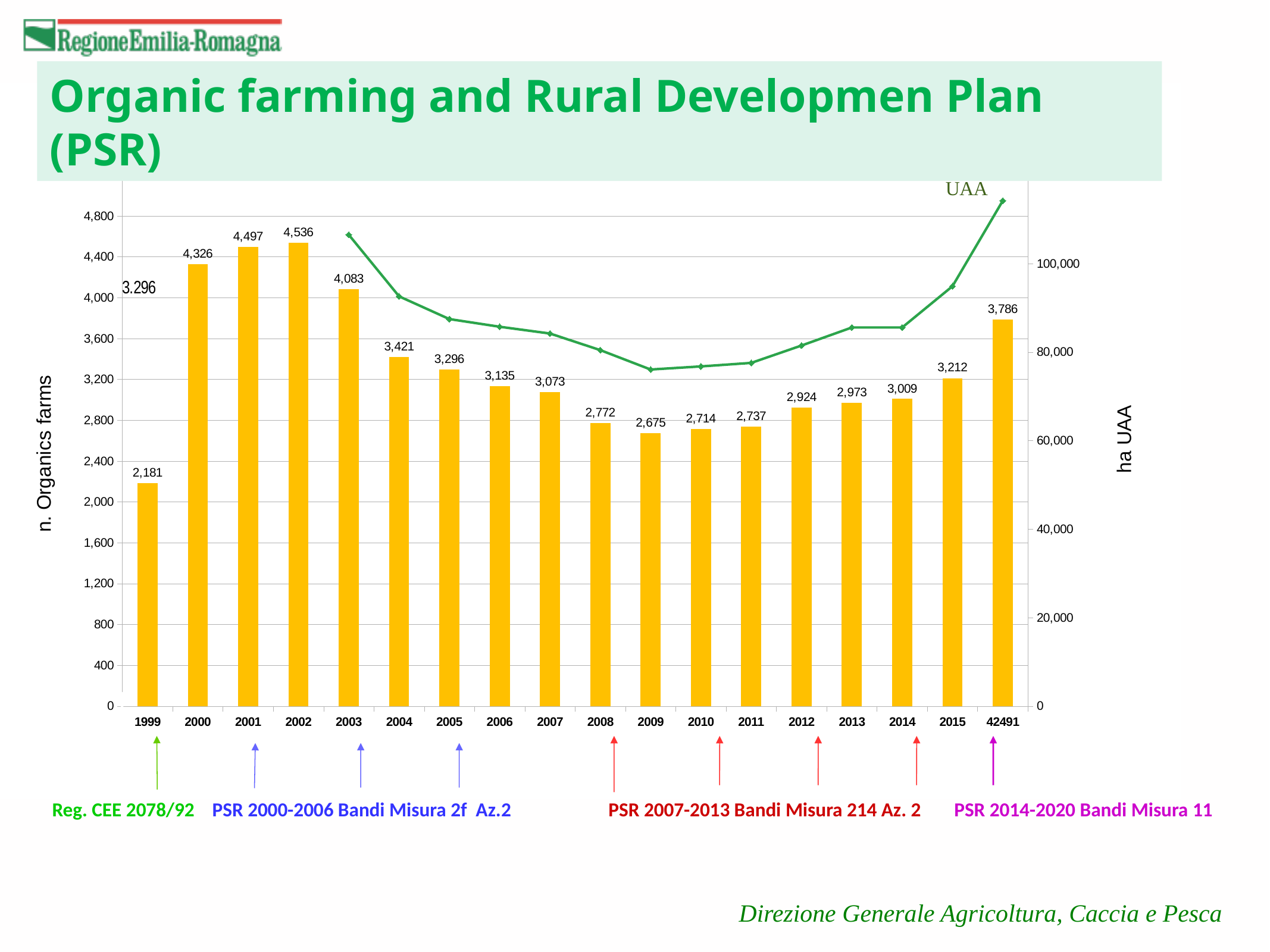
Is the UAA value for the last year on the chart greater or less than 100,000? greater What is the number of organic farms shown for 2009? 2,675 Which year has more organic farms, 2004 or 2012? 2004 How many bars are plotted in the chart? 18 Is the UAA value for 2009 greater or less than 80,000? less What is the difference in the number of organic farms between 2015 and 2014? 203 Which year has the lowest number of organic farms? 1999 What is the number of organic farms shown for 2015? 3,212 Which year has the highest number of organic farms? 2002 How many organic farms were there in 2002? 4,536 What is the label of the right-hand vertical axis? ha UAA What is the difference in the number of organic farms between 2000 and 1999? 2,145